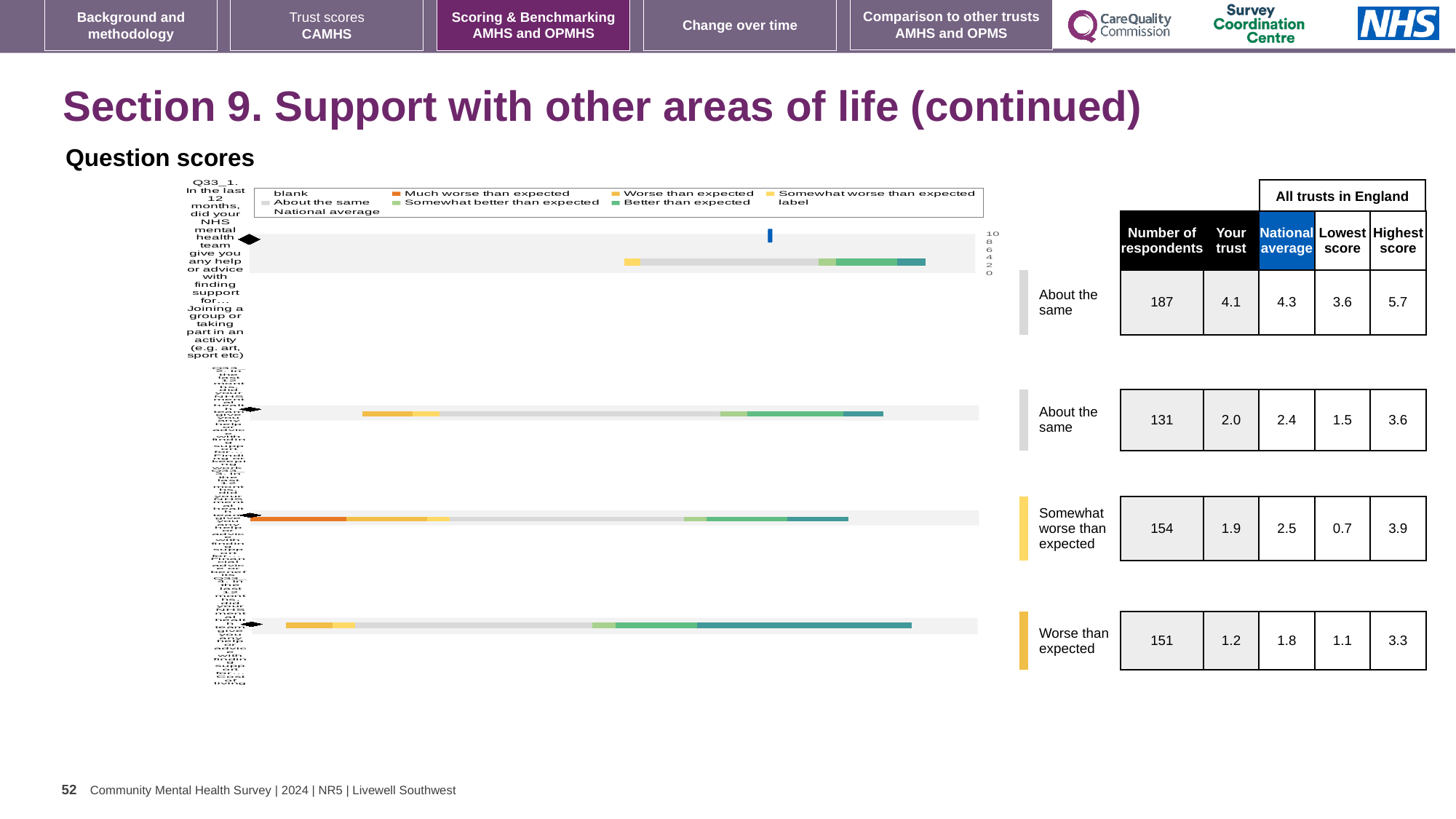
In the table beside the chart, what is the national average for the top row (Q33_1)? 4.3 In the table beside the chart, for the bottom row, is the 'Your trust' score or the national average larger? national average In the table beside the chart, what is the difference between the national average and the 'Your trust' score for the top row (Q33_1)? 0.2 What benchmark label is shown beside the bottom bar? Worse than expected In the table beside the chart, which row has the lowest 'Your trust' score? the bottom row (Worse than expected), 1.2 How many entries does the chart's legend list? 9 In the table beside the chart, what is the number of respondents for the top row (Q33_1, joining a group or taking part in an activity)? 187 In the chart's legend, what colour represents 'Much worse than expected'? orange How many question rows (bars) are plotted in the chart? 4 In the table beside the chart, what is the 'Your trust' score for the top row (Q33_1)? 4.1 What benchmark label is shown beside the third bar from the top? Somewhat worse than expected What kind of chart is shown on the slide? bar chart